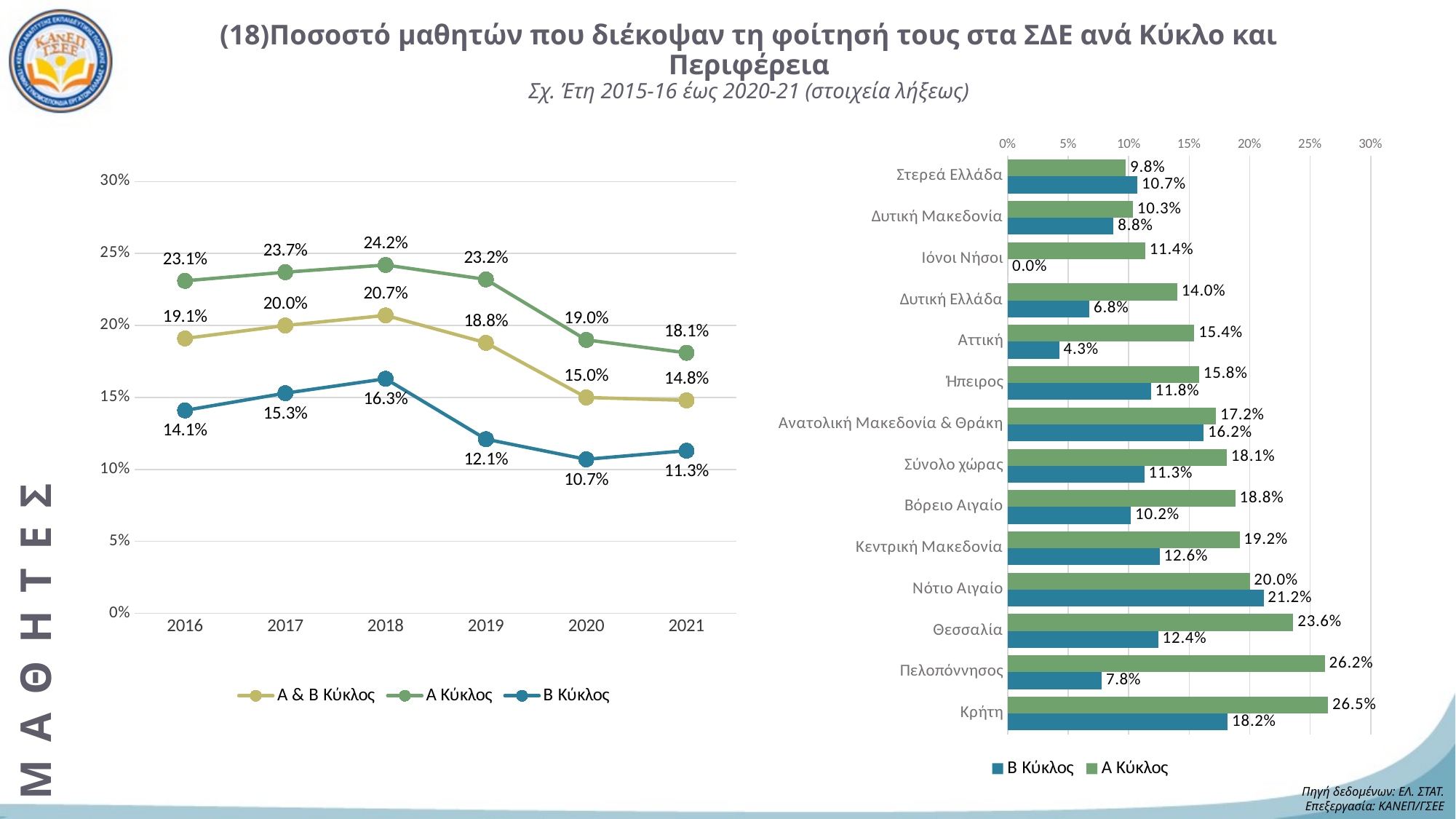
In the line chart on the left, what is the difference between Α Κύκλος and Β Κύκλος in 2021? 6.8% In the bar chart on the right, what is the Α Κύκλος value for Θεσσαλία? 23.6% In the bar chart on the right, which region has the highest Α Κύκλος value? Κρήτη In the line chart on the left, what is the value for Α Κύκλος in 2018? 24.2% In the line chart on the left, in which year is the Α & Β Κύκλος series highest? 2018 In the bar chart on the right, which is larger for Νότιο Αιγαίο, the Α Κύκλος value or the Β Κύκλος value? Β Κύκλος In the bar chart on the right, which region has the lowest Β Κύκλος value? Ιόνοι Νήσοι What kind of chart is shown on the right side of the slide? bar chart In the line chart on the left, what is the value for Β Κύκλος in 2020? 10.7% In the line chart on the left, does the Α Κύκλος series rise or fall from 2018 to 2021? fall In the line chart on the left, in which year is the Β Κύκλος series lowest? 2020 In the line chart on the left, how many series does the legend list? 3